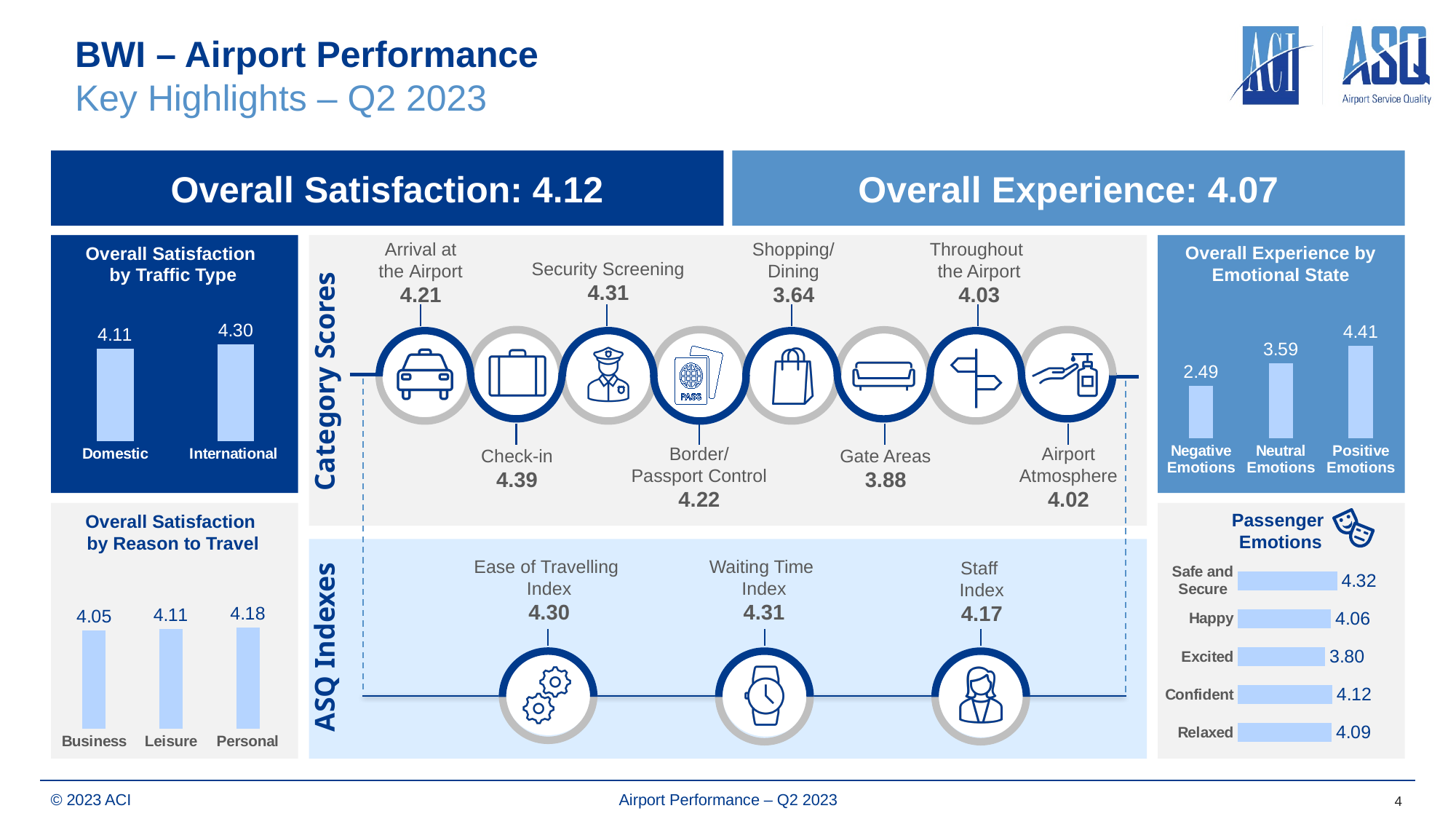
In the "Overall Satisfaction by Reason to Travel" chart, which category has the highest value? Personal In the "Overall Satisfaction by Traffic Type" chart, what is the value for International? 4.30 How many categories are shown in the "Overall Satisfaction by Reason to Travel" chart? 3 In the "Passenger Emotions" chart, what is the value for Excited? 3.80 In the "Overall Satisfaction by Traffic Type" chart, what is the difference between the International and Domestic values? 0.19 In the "Overall Experience by Emotional State" chart, which category has the lowest value? Negative Emotions In the "Overall Experience by Emotional State" chart, what is the difference between Positive Emotions and Neutral Emotions? 0.82 In the "Overall Satisfaction by Reason to Travel" chart, what is the value for Business? 4.05 In the "Overall Experience by Emotional State" chart, what is the value for Negative Emotions? 2.49 In the "Passenger Emotions" chart, which is larger, Confident or Relaxed? Confident What kind of chart is the "Passenger Emotions" chart? Bar chart In the "Passenger Emotions" chart, which emotion has the highest value? Safe and Secure